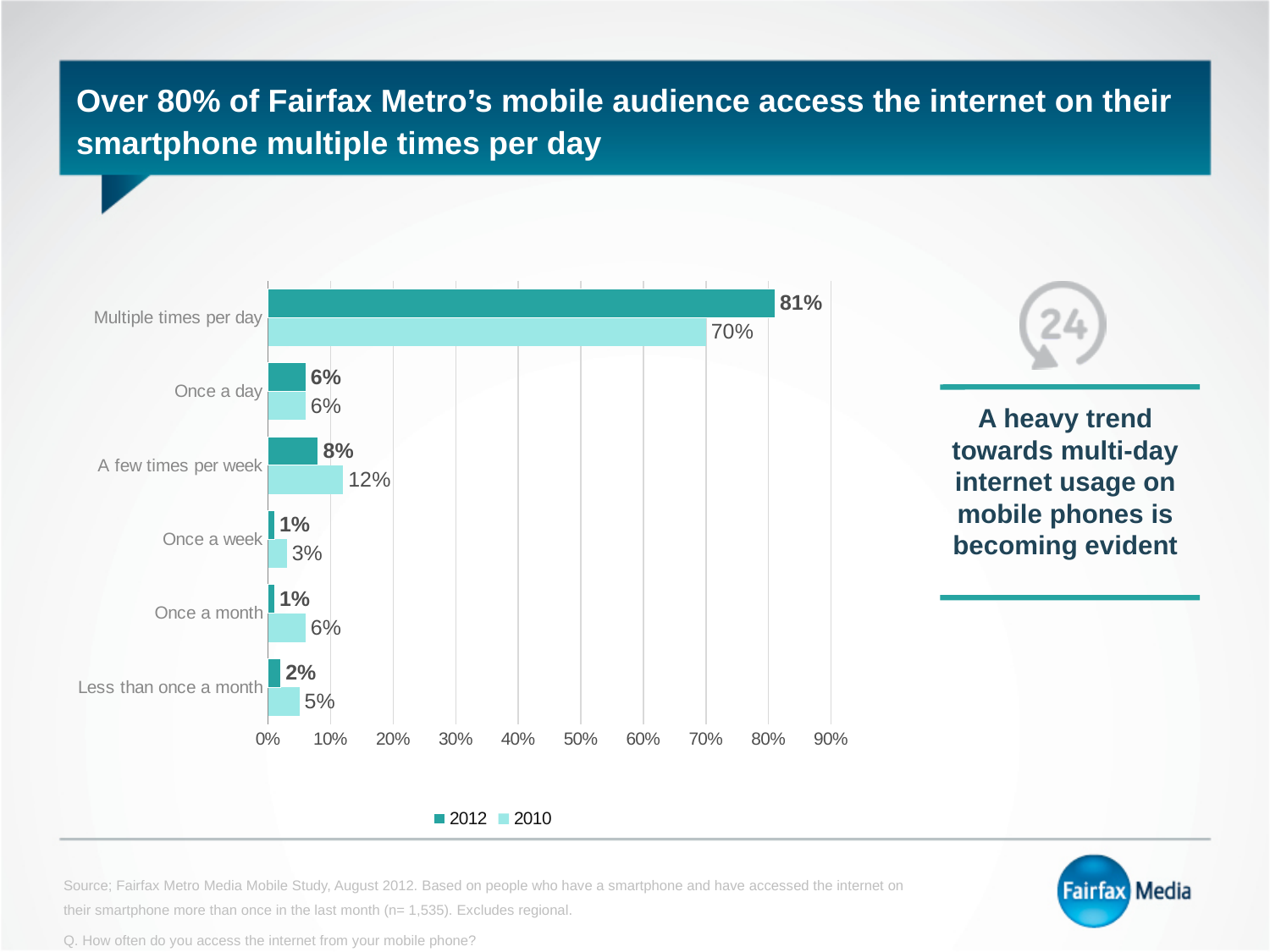
Which category has the lowest 2010 value? Once a week What is the difference between the 2012 and 2010 values for Multiple times per day? 11% What is the 2012 value for Multiple times per day? 81% Which category has the highest 2012 value? Multiple times per day What kind of chart is shown on the slide? Bar chart Which series is shown in the darker teal colour? 2012 How many series does the legend list? 2 How many categories are shown on the chart? 6 What is the 2010 value for Once a month? 6% Is the 2012 value for Multiple times per day greater or less than 80%? greater Which is larger for A few times per week, the 2012 value or the 2010 value? 2010 What is the 2010 value for A few times per week? 12%